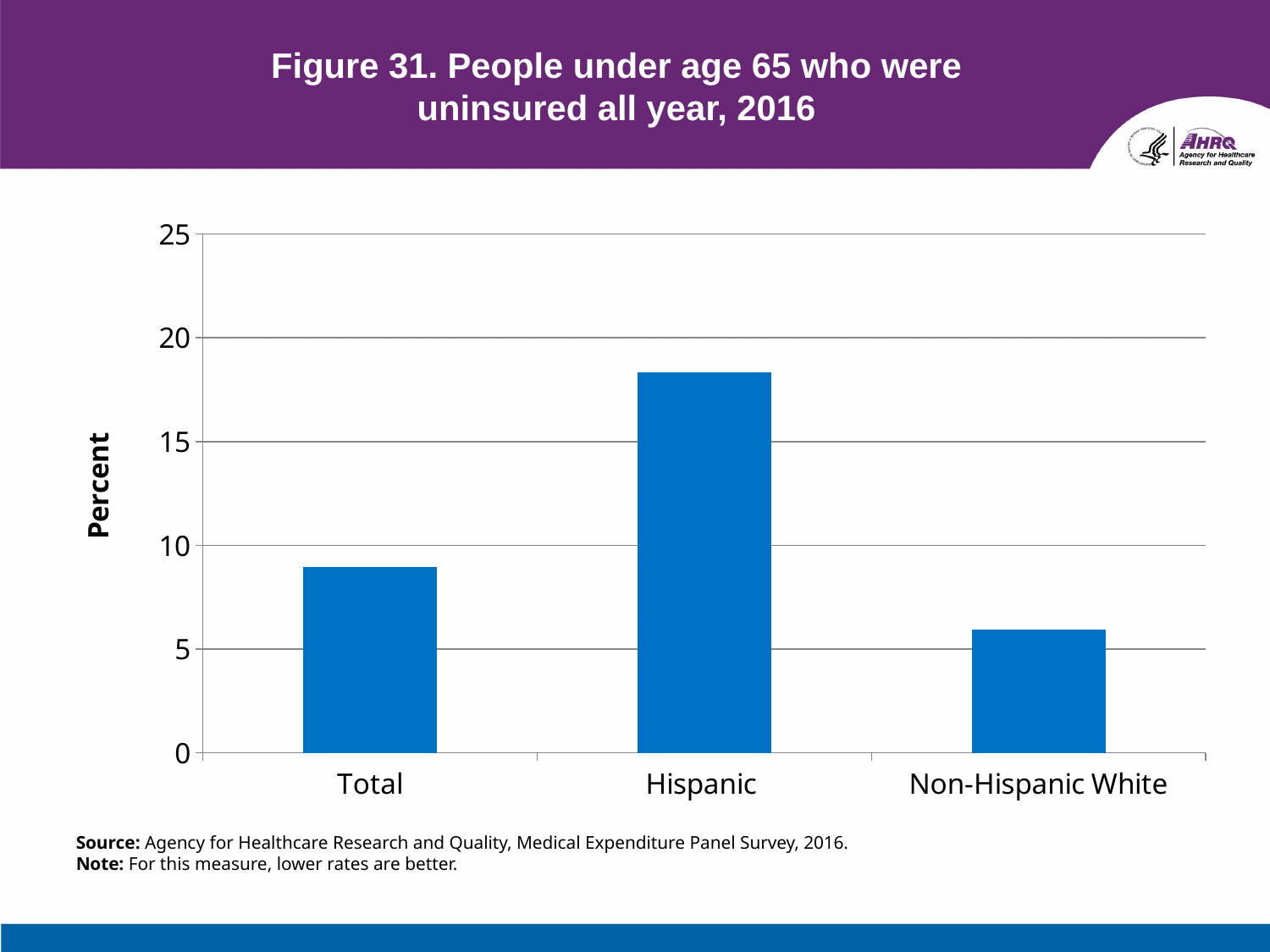
Which is larger, the value for Total or the value for Non-Hispanic White? Total Which category has the highest value? Hispanic How many categories are shown on the x axis? 3 Is the value for Total greater or less than 10? less What is the title of the chart? Figure 31. People under age 65 who were uninsured all year, 2016 Is the value for Non-Hispanic White greater or less than 5? greater Is the value for Hispanic greater or less than 20? less Which category has the lowest value? Non-Hispanic White What is the label on the y axis? Percent Which is larger, the value for Hispanic or the value for Total? Hispanic What kind of chart is shown on the slide? bar chart